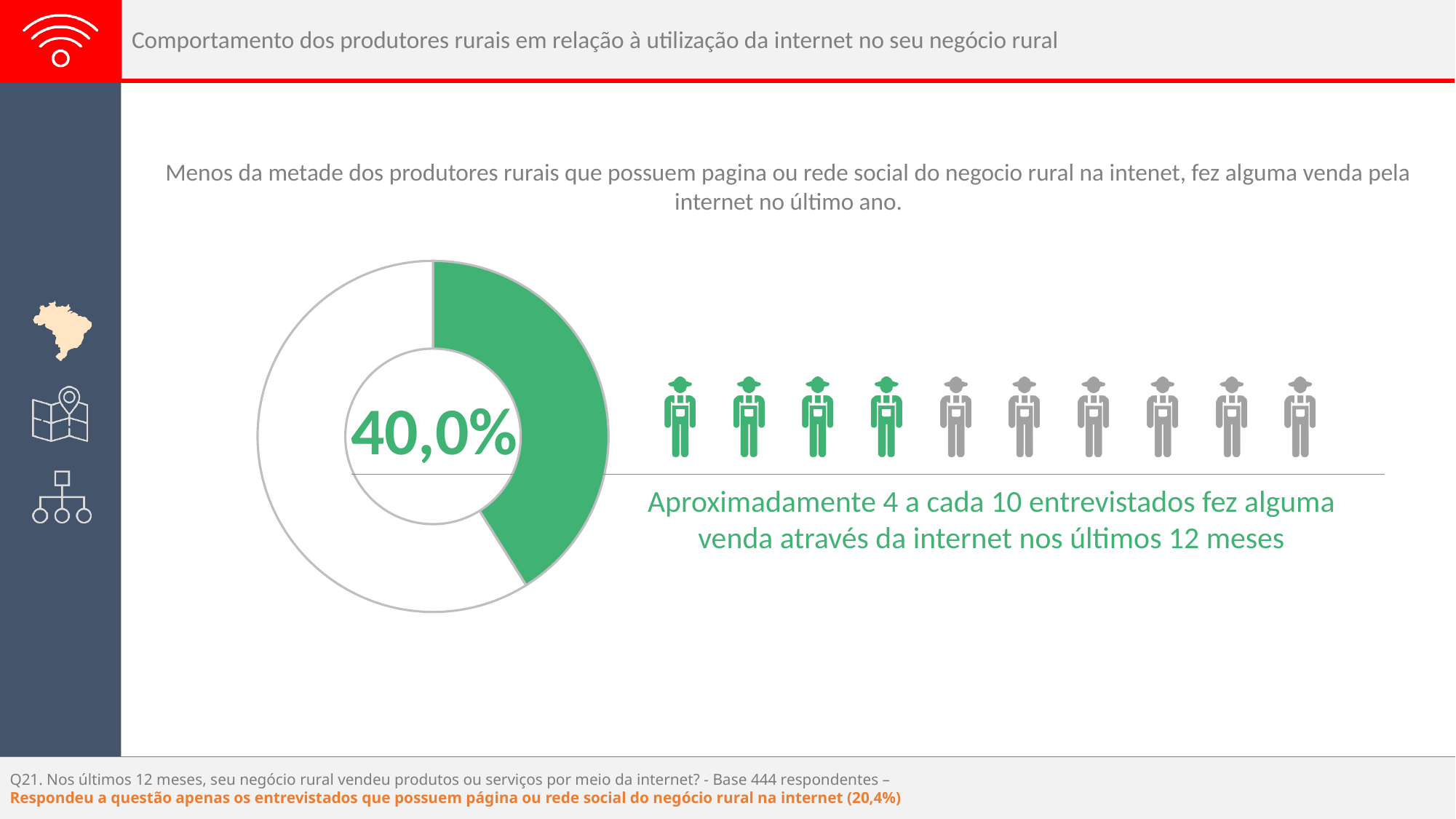
What percentage is printed in the centre of the donut chart? 40,0% Is the green share of the donut chart greater or less than 50%? less How many farmer icons are shown in the pictogram to the right of the donut chart? 10 What share of the donut chart is filled in green? 40,0% According to the green text under the pictogram, approximately how many out of every 10 respondents made a sale through the internet in the last 12 months? 4 a cada 10 What colour is the highlighted segment of the donut chart? Green How many respondents form the base for the chart, according to the footnote? 444 How many of the farmer icons in the pictogram are coloured green? 4 What kind of chart is shown on the left of the slide? Donut (pie) chart How many of the farmer icons in the pictogram are coloured grey? 6 Which is larger in the donut chart: the green segment or the white segment? The white segment